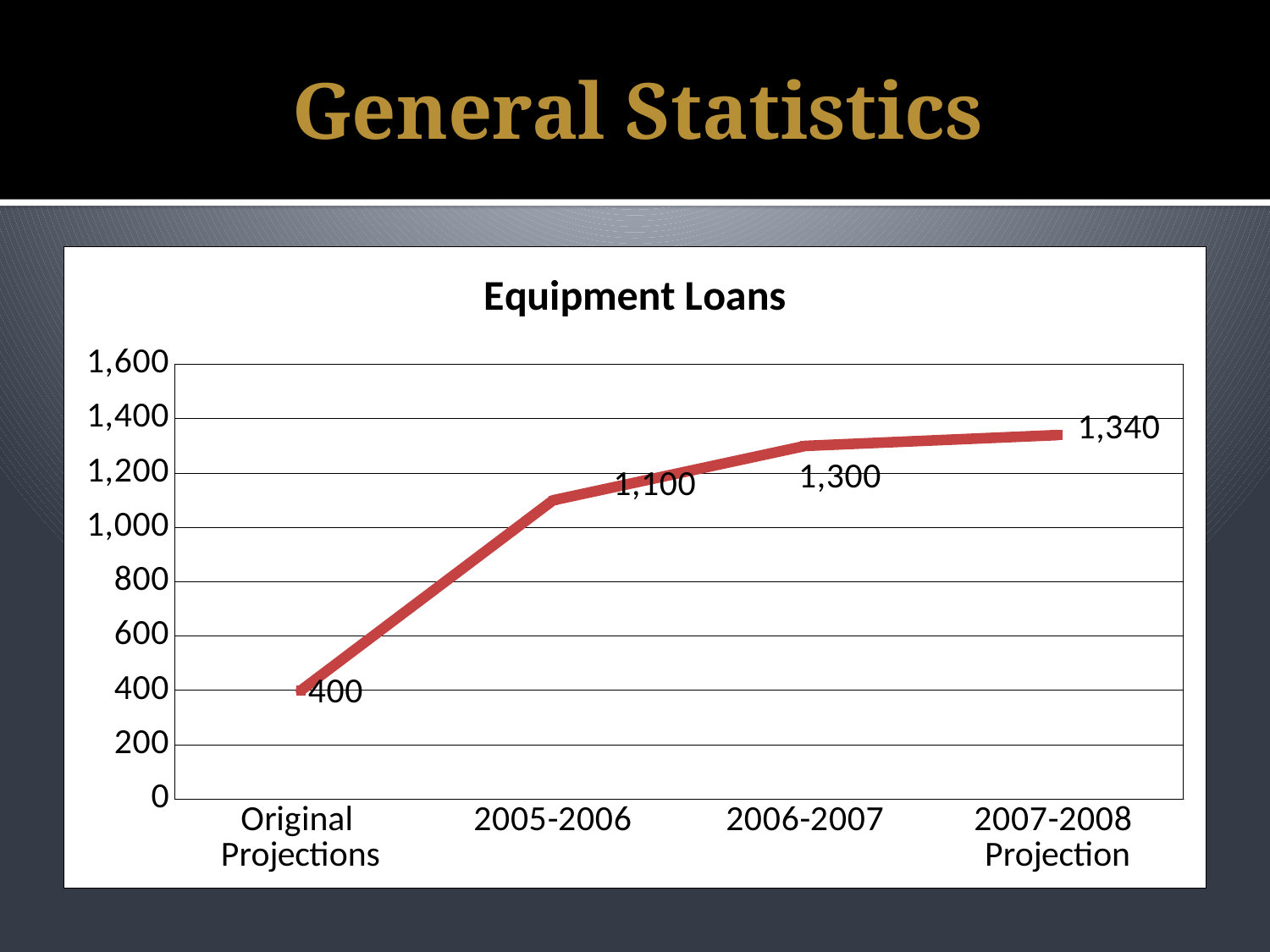
Do the values rise or fall from Original Projections to 2007-2008 Projection? rise What is the value for 2007-2008 Projection? 1,340 Which category has the highest value? 2007-2008 Projection What kind of chart is shown? line chart What is the difference between the values for 2007-2008 Projection and 2006-2007? 40 What is the value for 2005-2006? 1,100 What is the value for 2006-2007? 1,300 Which category has the lowest value? Original Projections How many categories are plotted on the x axis? 4 What is the value for Original Projections? 400 What is the difference between the values for 2005-2006 and Original Projections? 700 Which is larger, the value for 2005-2006 or the value for 2006-2007? 2006-2007